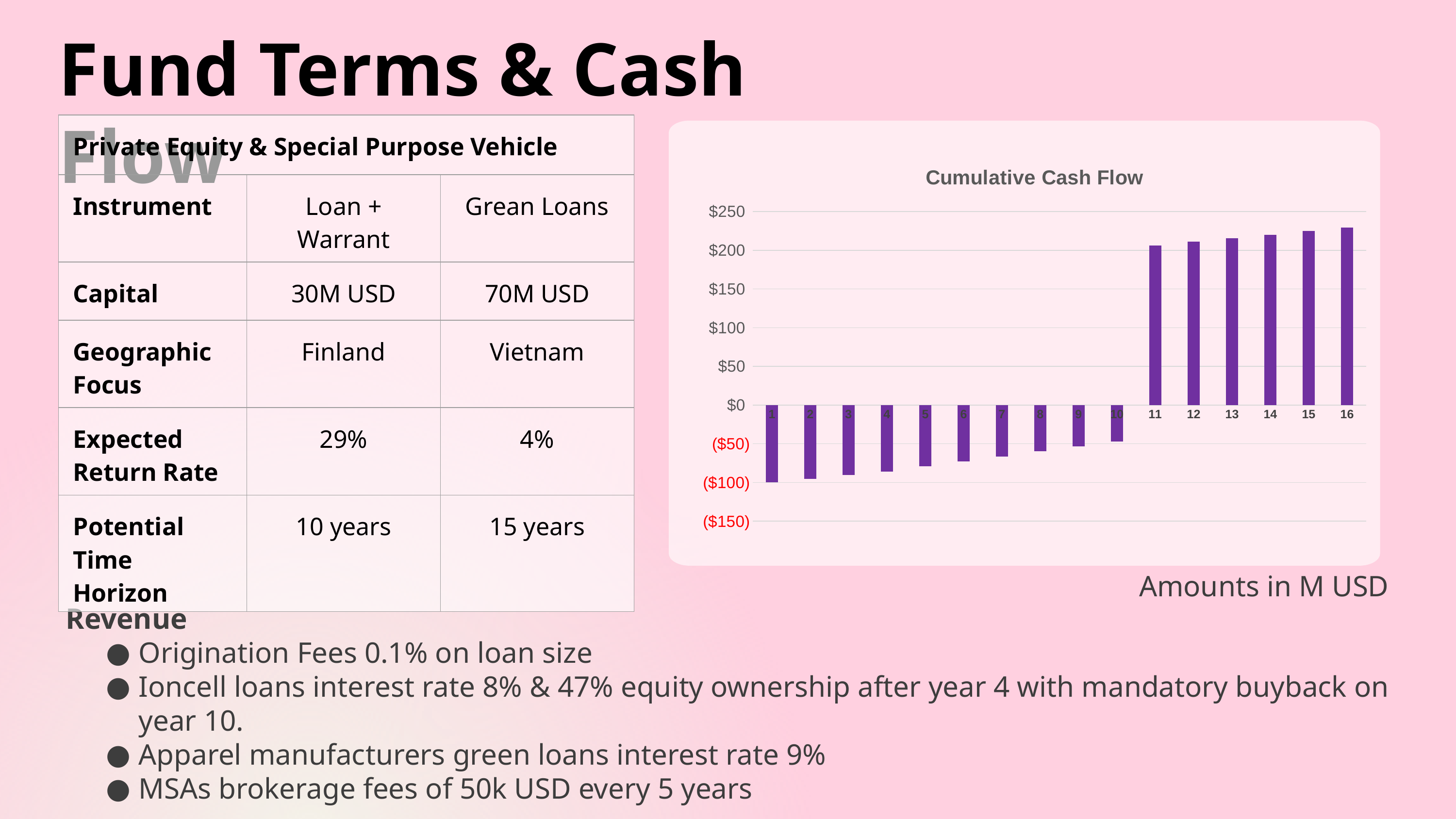
Is the cumulative cash flow for period 10 greater or less than $0? less Which period has the highest cumulative cash flow? 16 How many bars (periods) are plotted in the Cumulative Cash Flow chart? 16 Is the cumulative cash flow for period 1 greater or less than ($50)? less Is the cumulative cash flow for period 5 greater or less than ($50)? less What is the title of the chart? Cumulative Cash Flow Do the cumulative cash flow values rise or fall as the periods go from 1 to 16? rise Which is larger, the cumulative cash flow for period 11 or for period 16? 16 What colour are the bars in the Cumulative Cash Flow chart? purple What kind of chart is shown on the slide? bar chart